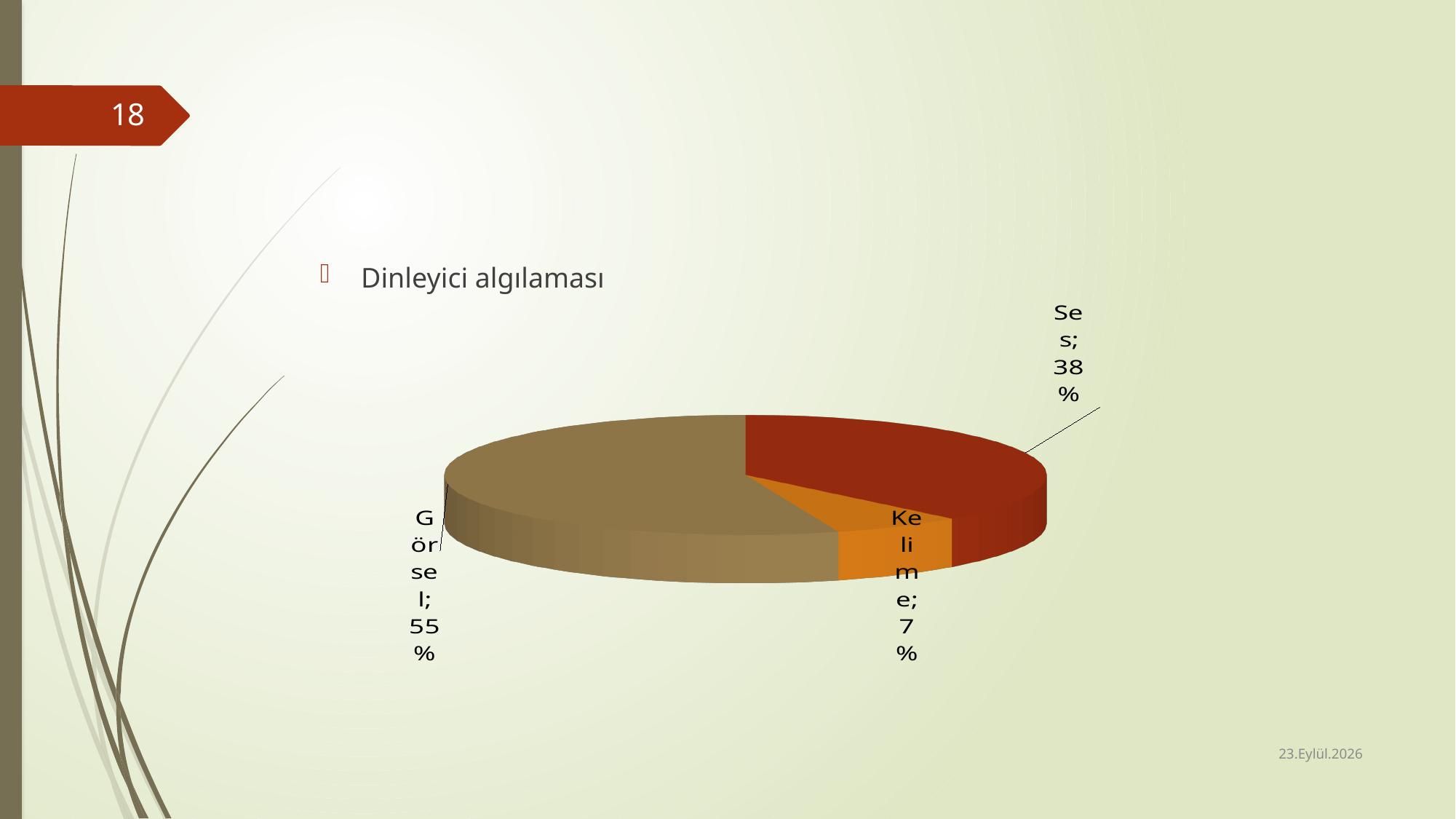
What is the difference in percentage points between Görsel and Ses? 17 What is the difference in percentage points between Ses and Kelime? 31 Which slice of the pie chart is the largest? Görsel Which is larger in the pie chart, Ses or Kelime? Ses What kind of chart is shown on the slide? pie chart How many slices does the pie chart have? 3 What percentage is shown for Ses in the pie chart? 38% What percentage is shown for Görsel in the pie chart? 55% What percentage is shown for Kelime in the pie chart? 7% Which slice of the pie chart is the smallest? Kelime What colour is the Ses slice in the pie chart? dark red What share of the pie does the Görsel slice represent? 55%